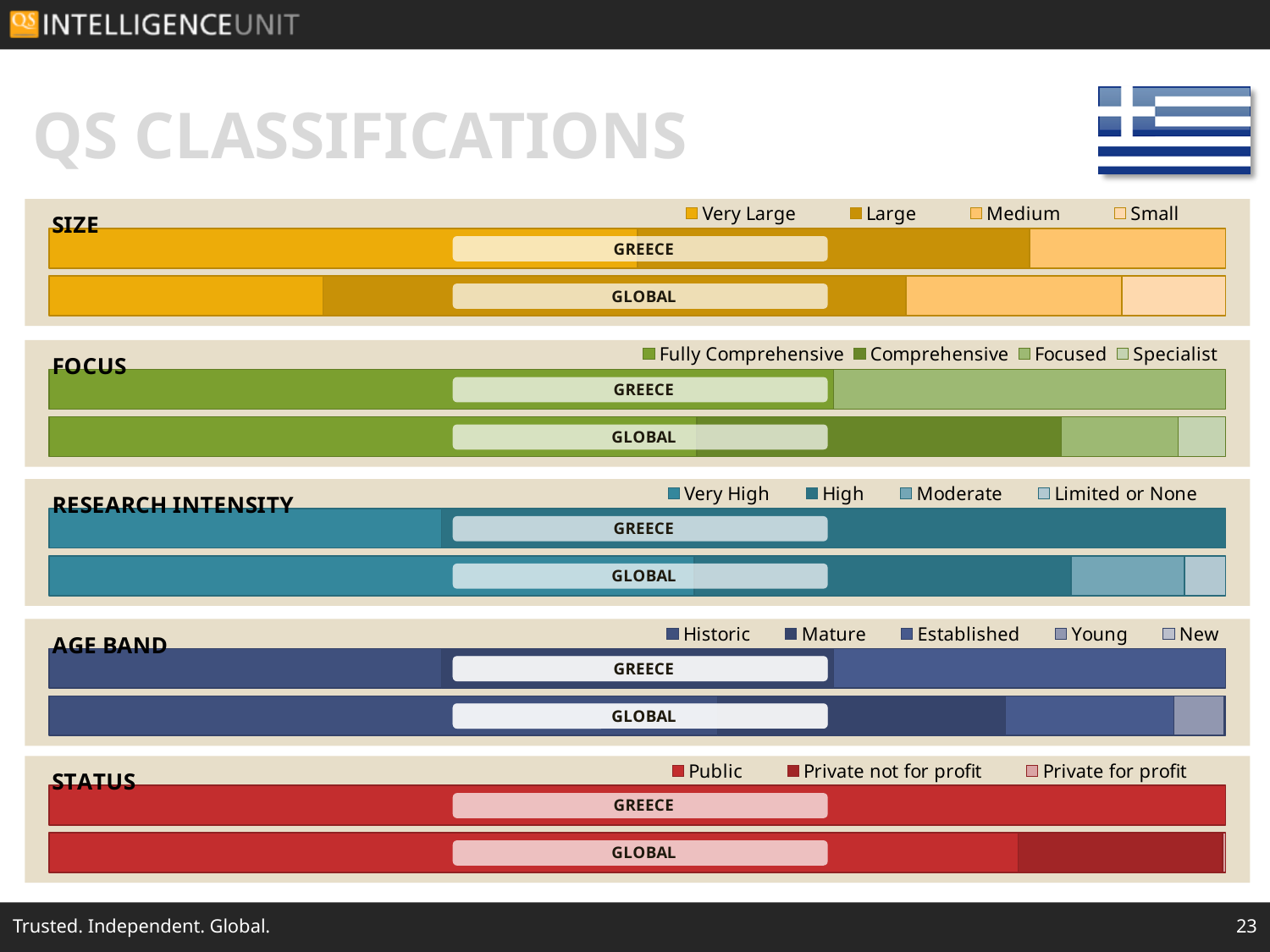
Which two bars are labelled in each chart on the slide? GREECE and GLOBAL In the SIZE chart, which category makes up the largest share of the GREECE bar? Very Large How many series does the legend of the SIZE chart list? 4 In the SIZE chart, is the Very Large share larger for GREECE or for GLOBAL? GREECE How many series does the legend of the STATUS chart list? 3 In the SIZE chart, which category makes up the largest share of the GLOBAL bar? Large In the AGE BAND chart, which category makes up the largest share of the GLOBAL bar? Historic How many series does the legend of the AGE BAND chart list? 5 How many classification charts are shown on the slide? 5 What kind of chart is used for the SIZE section? bar chart How many bars does the FOCUS chart contain? 2